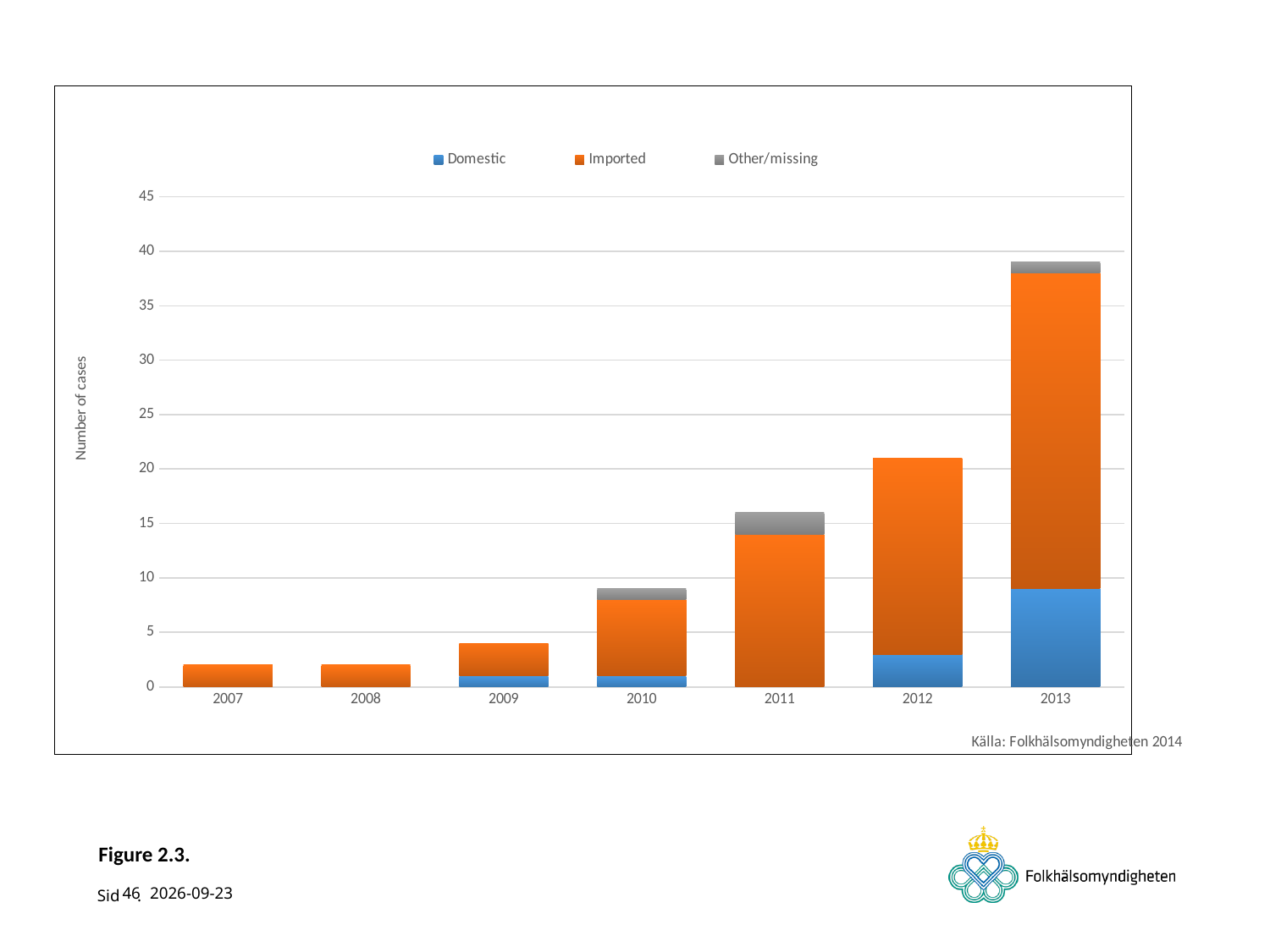
How many series does the legend list? 3 Is the total number of cases for 2009 greater or less than 5? less Is the total number of cases for 2010 greater or less than 10? less Do the total number of cases generally rise or fall from 2007 to 2013? rise Which year has the highest total number of cases? 2013 How many years are shown on the x axis? 7 Is the total number of cases for 2013 greater or less than 35? greater What kind of chart is shown on the slide? stacked bar chart What is the label of the y axis? Number of cases Which series is shown in blue in the legend? Domestic Which year has a larger total number of cases, 2011 or 2012? 2012